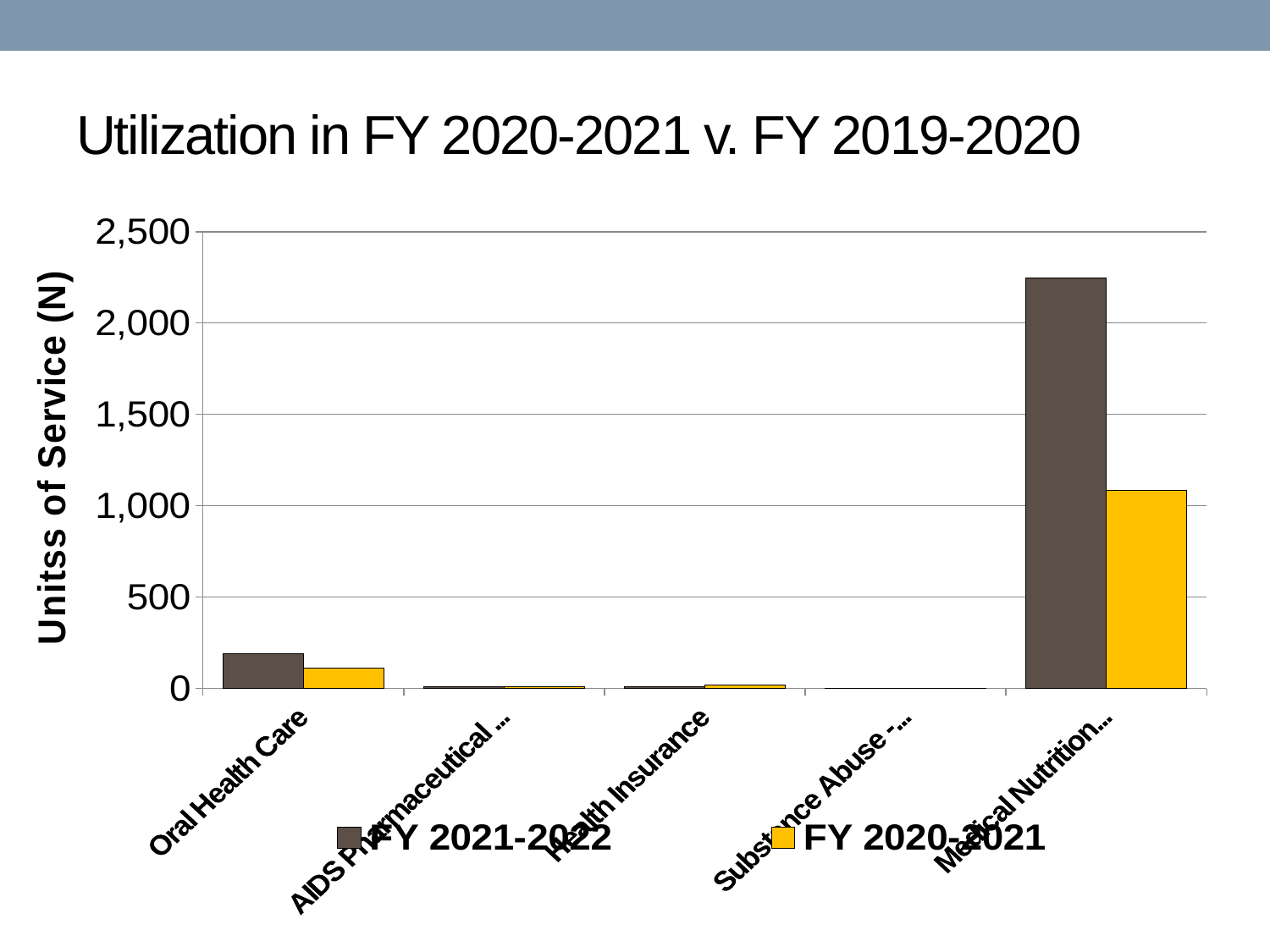
Which series is shown in yellow? FY 2020-2021 How many service categories are shown on the x axis? 5 How many series does the legend list? 2 For Medical Nutrition, which series has the larger value, FY 2021-2022 or FY 2020-2021? FY 2021-2022 Is the FY 2021-2022 value for Medical Nutrition greater or less than 2,000? greater What kind of chart is shown on the slide? bar chart Is the FY 2021-2022 value for Oral Health Care greater or less than 500? less Which category has the highest value for FY 2020-2021? Medical Nutrition For Oral Health Care, which series has the larger value, FY 2021-2022 or FY 2020-2021? FY 2021-2022 Which category has the highest value for FY 2021-2022? Medical Nutrition What is the title of the chart? Utilization in FY 2020-2021 v. FY 2019-2020 Is the FY 2020-2021 value for Medical Nutrition greater or less than 1,500? less